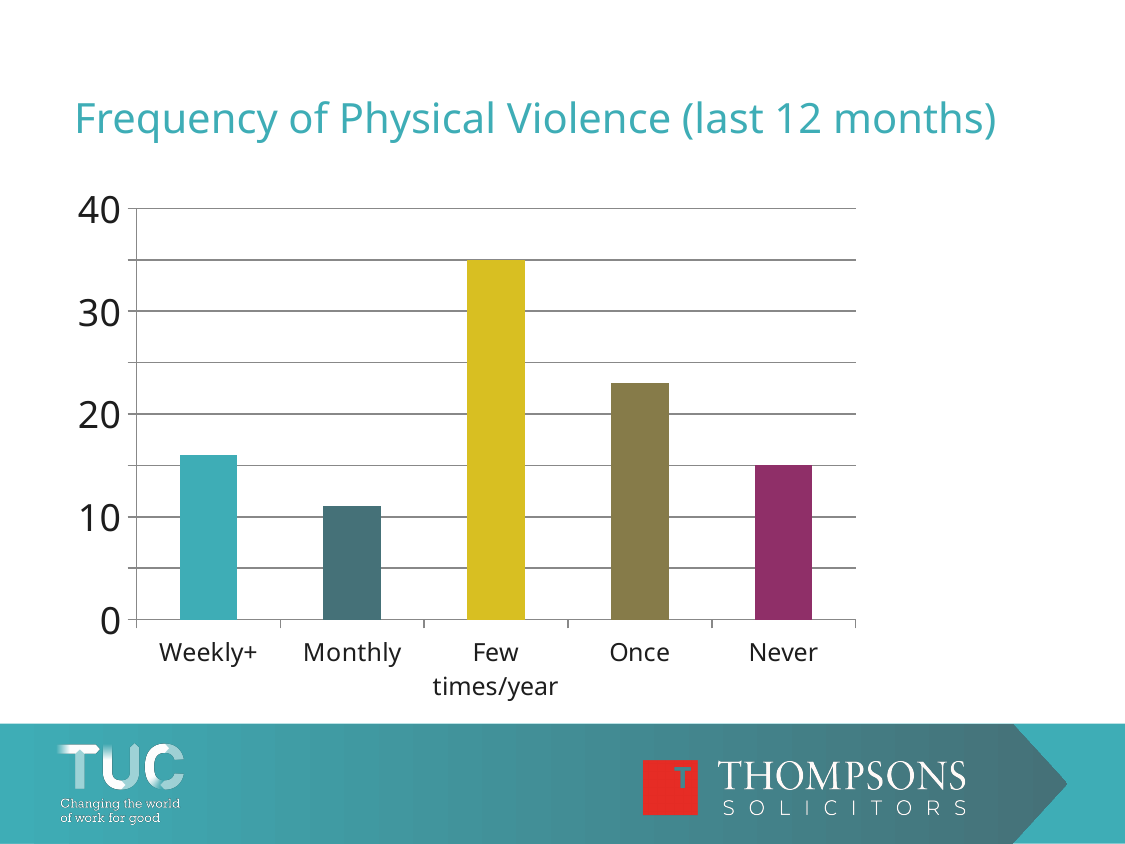
Is the value for Few times/year greater or less than 30? greater Is the value for Weekly+ greater or less than 20? less Which is larger, the value for Once or the value for Weekly+? Once Is the value for Never greater or less than 10? greater How many categories are shown on the x axis? 5 What kind of chart is shown on the slide? bar chart Which category has the highest value? Few times/year What is the title of the chart? Frequency of Physical Violence (last 12 months) Which category has the lowest value? Monthly